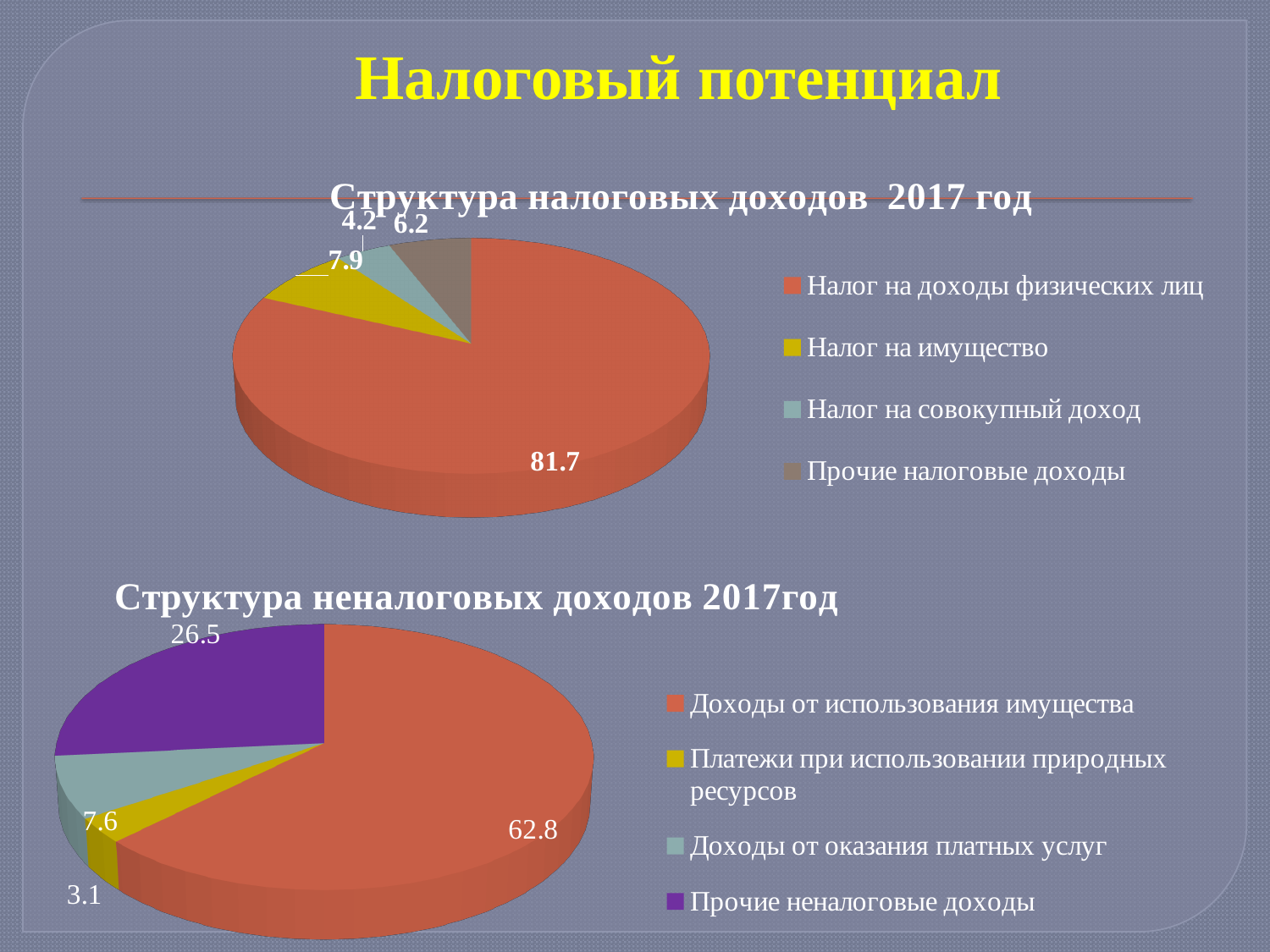
In the chart 'Структура налоговых доходов 2017 год', what is the difference between 'Прочие налоговые доходы' and 'Налог на совокупный доход'? 2.0 In the chart 'Структура неналоговых доходов 2017год', what is the difference between 'Доходы от использования имущества' and 'Прочие неналоговые доходы'? 36.3 In the chart 'Структура неналоговых доходов 2017год', which category has the smallest value? Платежи при использовании природных ресурсов In the chart 'Структура налоговых доходов 2017 год', how many categories does the legend list? 4 In the chart 'Структура налоговых доходов 2017 год', which category has the smallest value? Налог на совокупный доход In the chart 'Структура налоговых доходов 2017 год', what is the value for 'Налог на доходы физических лиц'? 81.7 In the chart 'Структура неналоговых доходов 2017год', which is larger: 'Доходы от оказания платных услуг' or 'Платежи при использовании природных ресурсов'? Доходы от оказания платных услуг In the chart 'Структура налоговых доходов 2017 год', what is the value for 'Налог на имущество'? 7.9 In the chart 'Структура неналоговых доходов 2017год', what is the value for 'Доходы от использования имущества'? 62.8 What type of chart is 'Структура неналоговых доходов 2017год'? Pie chart In the chart 'Структура неналоговых доходов 2017год', what is the value for 'Прочие неналоговые доходы'? 26.5 In the chart 'Структура налоговых доходов 2017 год', what colour is the slice for 'Налог на имущество'? Yellow